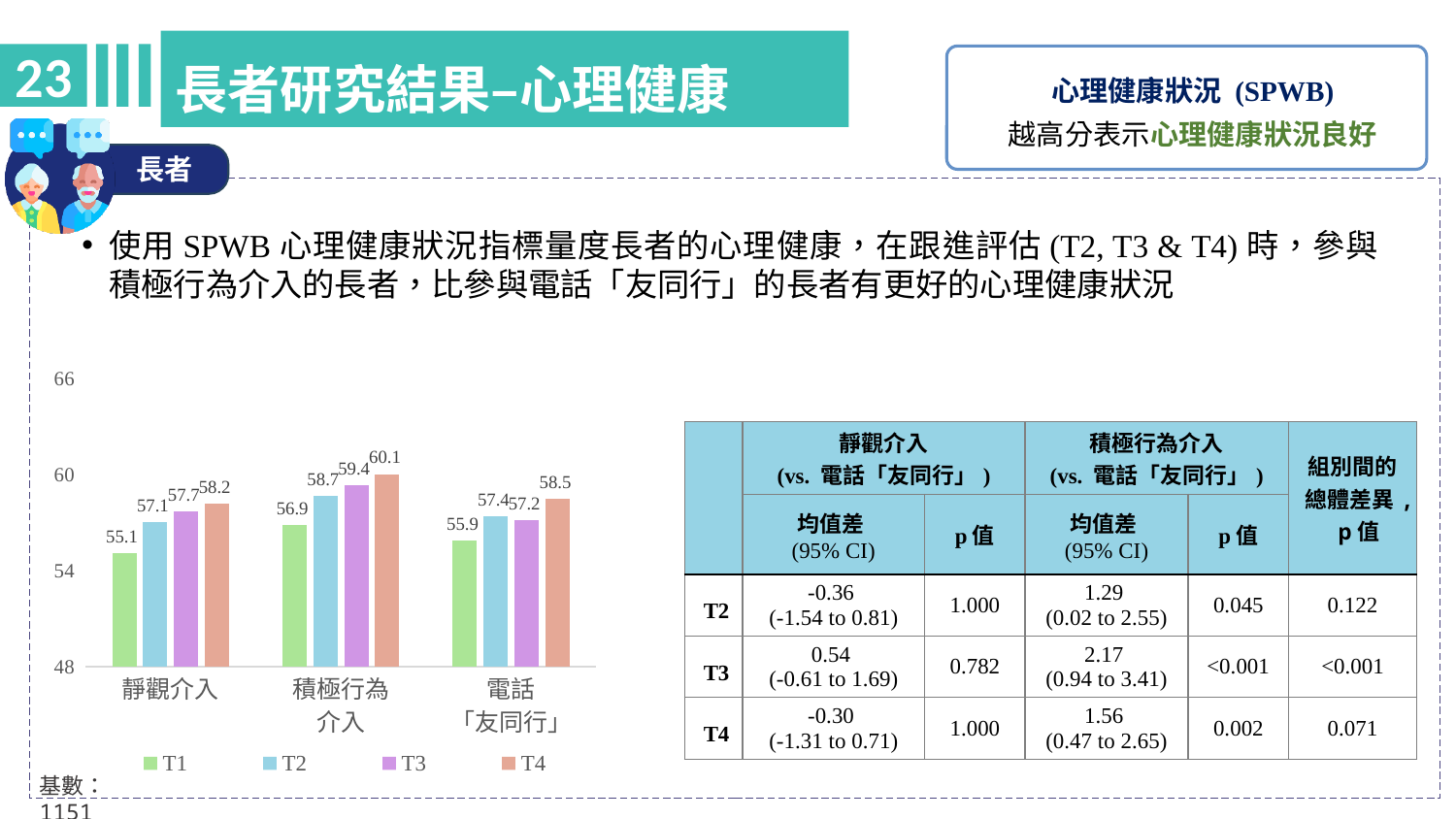
What is the difference between the T4 and T1 values for 積極行為介入? 3.2 What kind of chart is shown on the slide? bar chart How many categories are shown on the x axis of the chart? 3 Is the T4 value for 靜觀介入 greater or less than 60? less Which category has the highest T4 value? 積極行為介入 What is the T4 value for 積極行為介入? 60.1 Which is larger, the T2 value for 積極行為介入 or the T2 value for 電話「友同行」? 積極行為介入 Which category has the lowest T1 value? 靜觀介入 What is the T1 value for 靜觀介入? 55.1 Do the values for 積極行為介入 rise or fall from T1 to T4? rise What is the T3 value for 電話「友同行」? 57.2 How many series does the chart legend list? 4